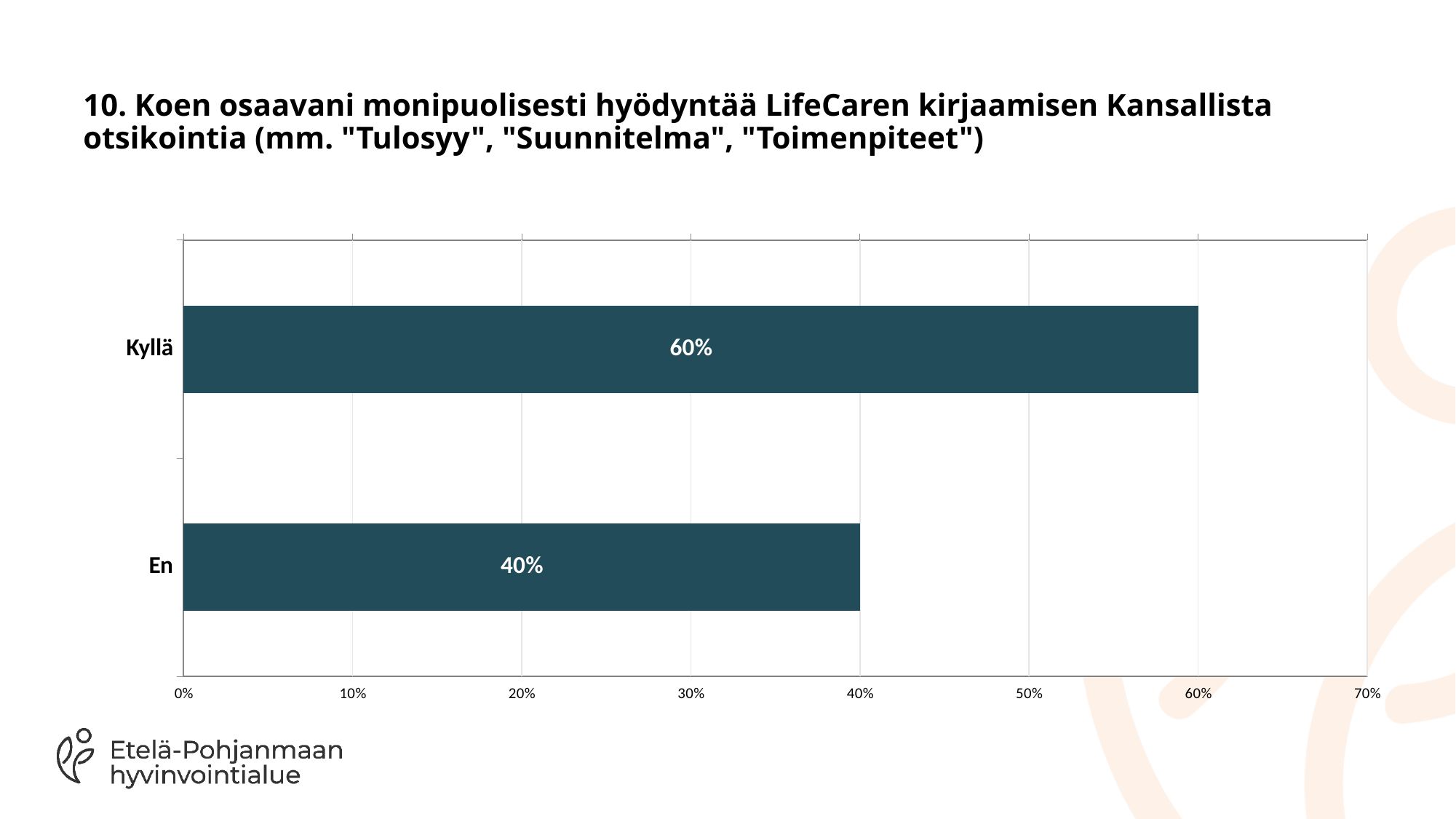
What is the total of the values for Kyllä and En? 100% What is the value for Kyllä? 60% Which is larger, the value for Kyllä or the value for En? Kyllä What is the highest value shown on the x axis? 70% Which category has the highest value? Kyllä What is the difference between the values for Kyllä and En? 20% What is the value for En? 40% Which category has the lowest value? En Is the value for En greater or less than 50%? less How many categories are shown in the chart? 2 What kind of chart is shown on the slide? bar chart Is the value for Kyllä greater or less than 50%? greater